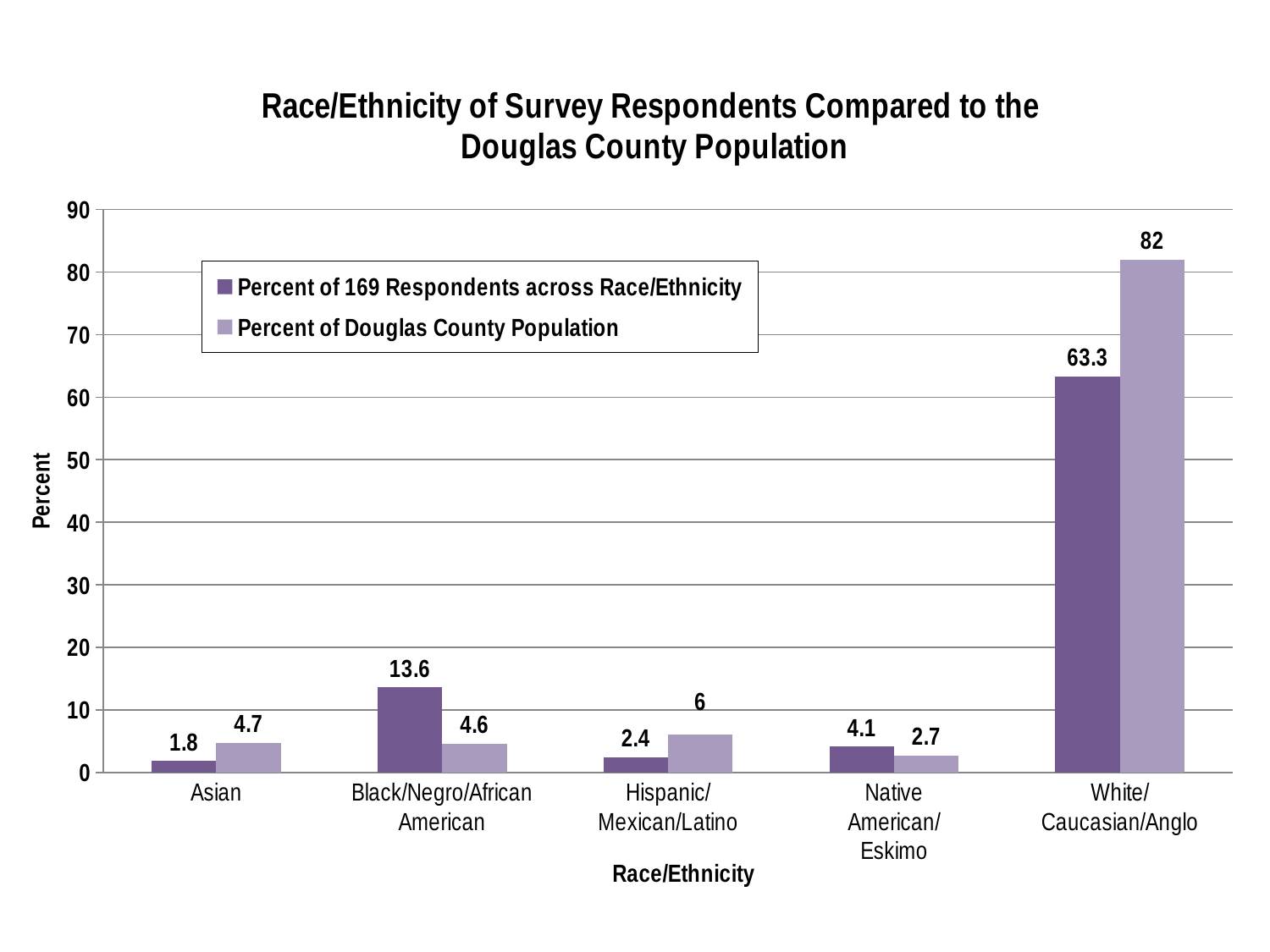
What percent of the 169 respondents are Black/Negro/African American? 13.6 For Native American/Eskimo, which is larger: the Percent of 169 Respondents or the Percent of Douglas County Population? Percent of 169 Respondents across Race/Ethnicity What is the Percent of 169 Respondents across Race/Ethnicity for Asian? 1.8 What is the difference between the Percent of Douglas County Population and the Percent of 169 Respondents for White/Caucasian/Anglo? 18.7 What kind of chart is shown on the slide? bar chart What is the Percent of Douglas County Population for Hispanic/Mexican/Latino? 6 What is the label of the y axis? Percent How many series does the legend list? 2 How many race/ethnicity categories are shown on the x axis? 5 Which race/ethnicity has the highest Percent of Douglas County Population? White/Caucasian/Anglo Is the Percent of 169 Respondents for White/Caucasian/Anglo greater or less than 70? less Which race/ethnicity has the lowest Percent of 169 Respondents across Race/Ethnicity? Asian